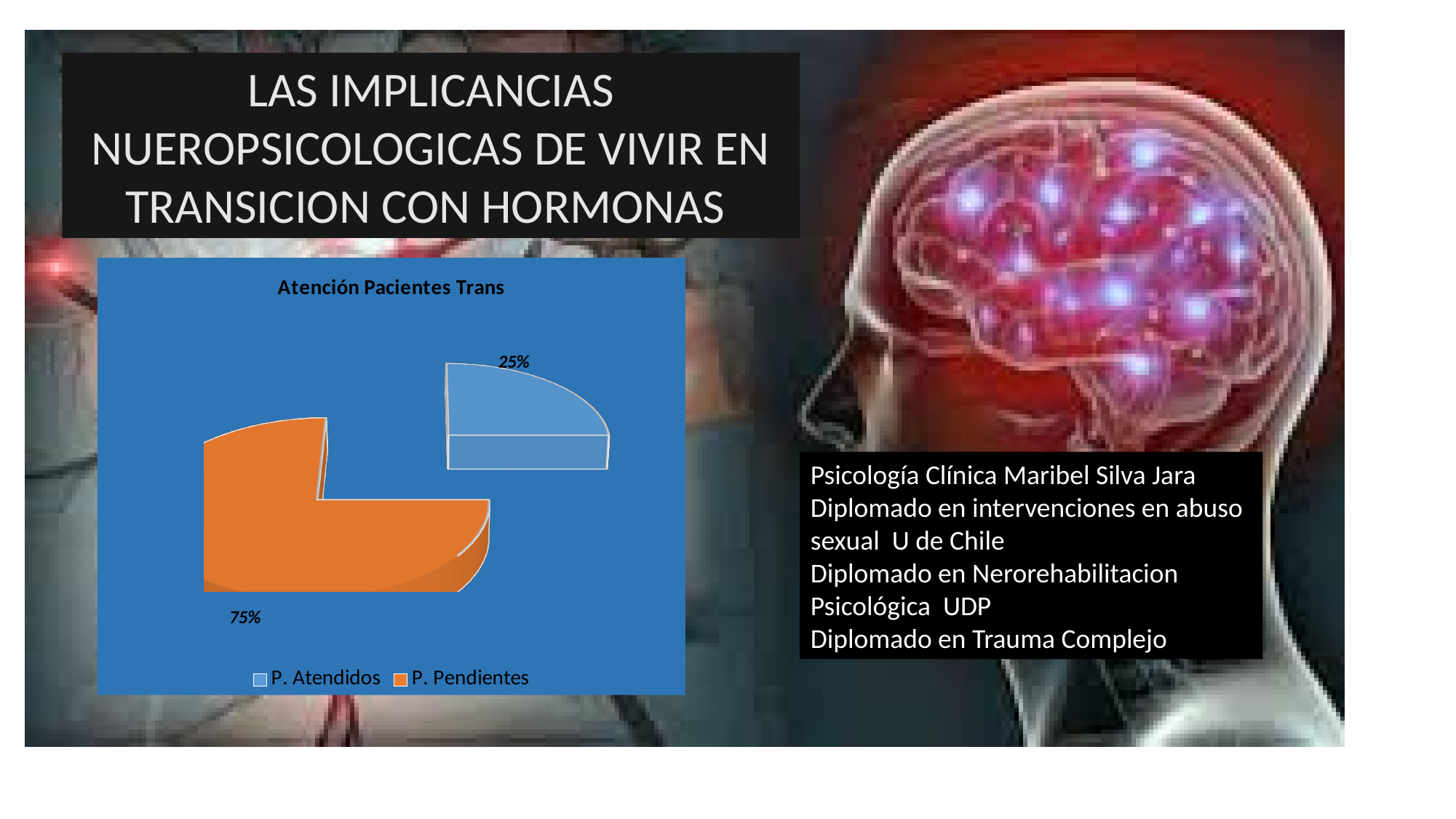
What is the difference in percentage points between P. Pendientes and P. Atendidos? 50% What is the title of the chart? Atención Pacientes Trans How many entries does the legend list? 2 How many slices does the pie chart have? 2 What share of the pie is P. Atendidos? 25% What colour is the P. Pendientes slice? orange Which category has the largest slice of the pie? P. Pendientes Which category has the smallest slice of the pie? P. Atendidos What share of the pie is P. Pendientes? 75% Which is larger, P. Atendidos or P. Pendientes? P. Pendientes What kind of chart is shown on the slide? pie chart